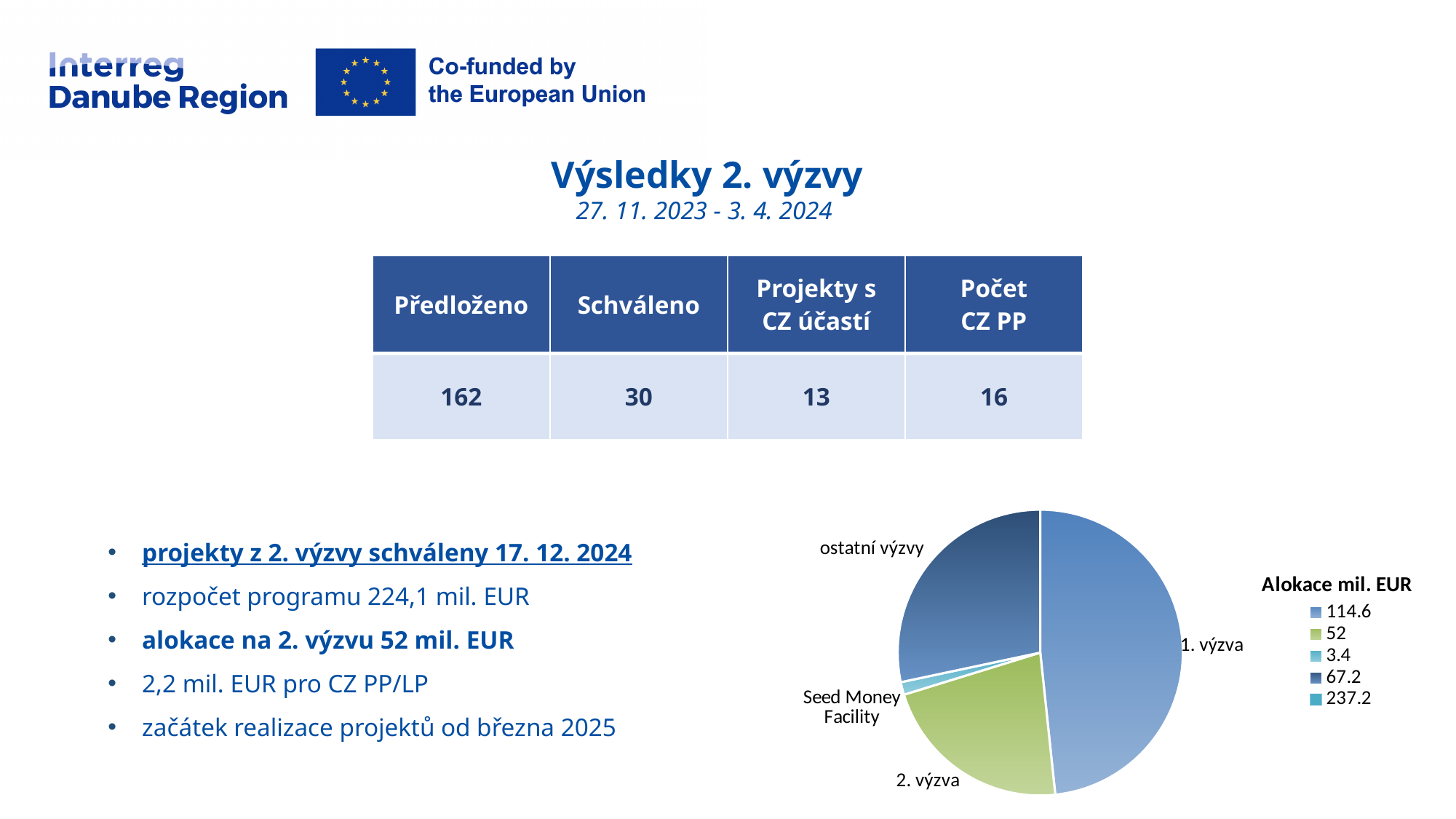
Which slice is larger in the pie chart: 2. výzva or ostatní výzvy? ostatní výzvy How many labelled slices does the pie chart have? 4 What is the title of the pie chart's legend? Alokace mil. EUR According to the legend, what is the allocation (mil. EUR) for the ostatní výzvy slice? 67.2 According to the legend, what is the allocation (mil. EUR) for the 2. výzva slice? 52 Which slice of the pie chart is the smallest? Seed Money Facility According to the legend, what is the allocation (mil. EUR) for the 1. výzva slice? 114.6 Which slice of the pie chart is the largest? 1. výzva Which slice is larger in the pie chart: 1. výzva or 2. výzva? 1. výzva How many entries does the pie chart's legend list? 5 What kind of chart is shown on the slide? pie chart According to the legend, what is the allocation (mil. EUR) for the Seed Money Facility slice? 3.4